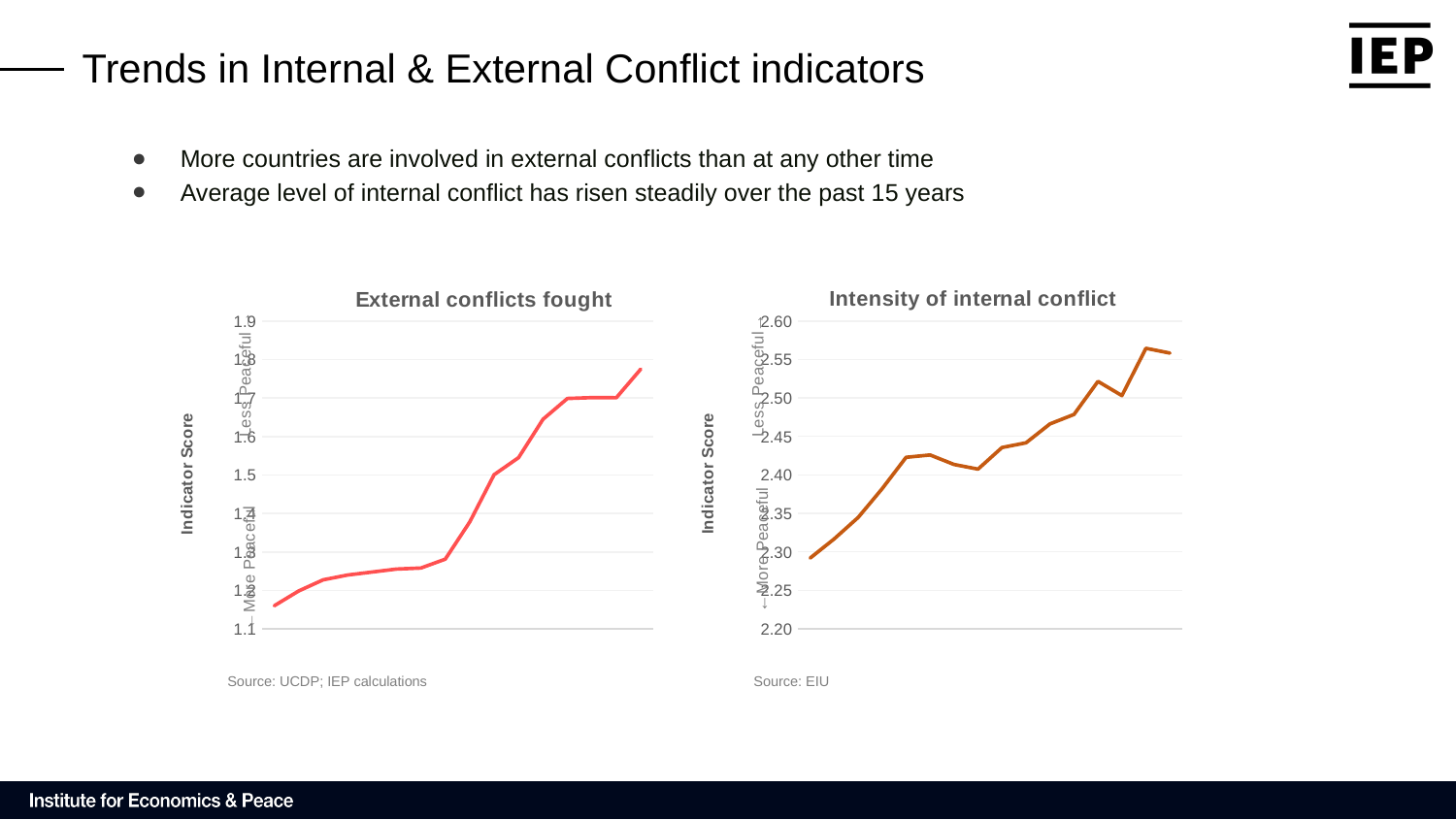
In the 'Intensity of internal conflict' chart, is the value of the last point on the line greater or less than 2.50? greater In the 'External conflicts fought' chart, is the lowest point on the line greater or less than 1.3? less In the 'Intensity of internal conflict' chart, is the value of the first point on the line greater or less than 2.35? less What is the title of the chart on the right side of the slide? Intensity of internal conflict What kind of chart is the 'Intensity of internal conflict' chart? line chart In the 'External conflicts fought' chart, do the values generally rise or fall from left to right? rise What kind of chart is the 'External conflicts fought' chart? line chart In the 'Intensity of internal conflict' chart, do the values generally rise or fall from left to right? rise What source is cited below the 'External conflicts fought' chart? UCDP; IEP calculations